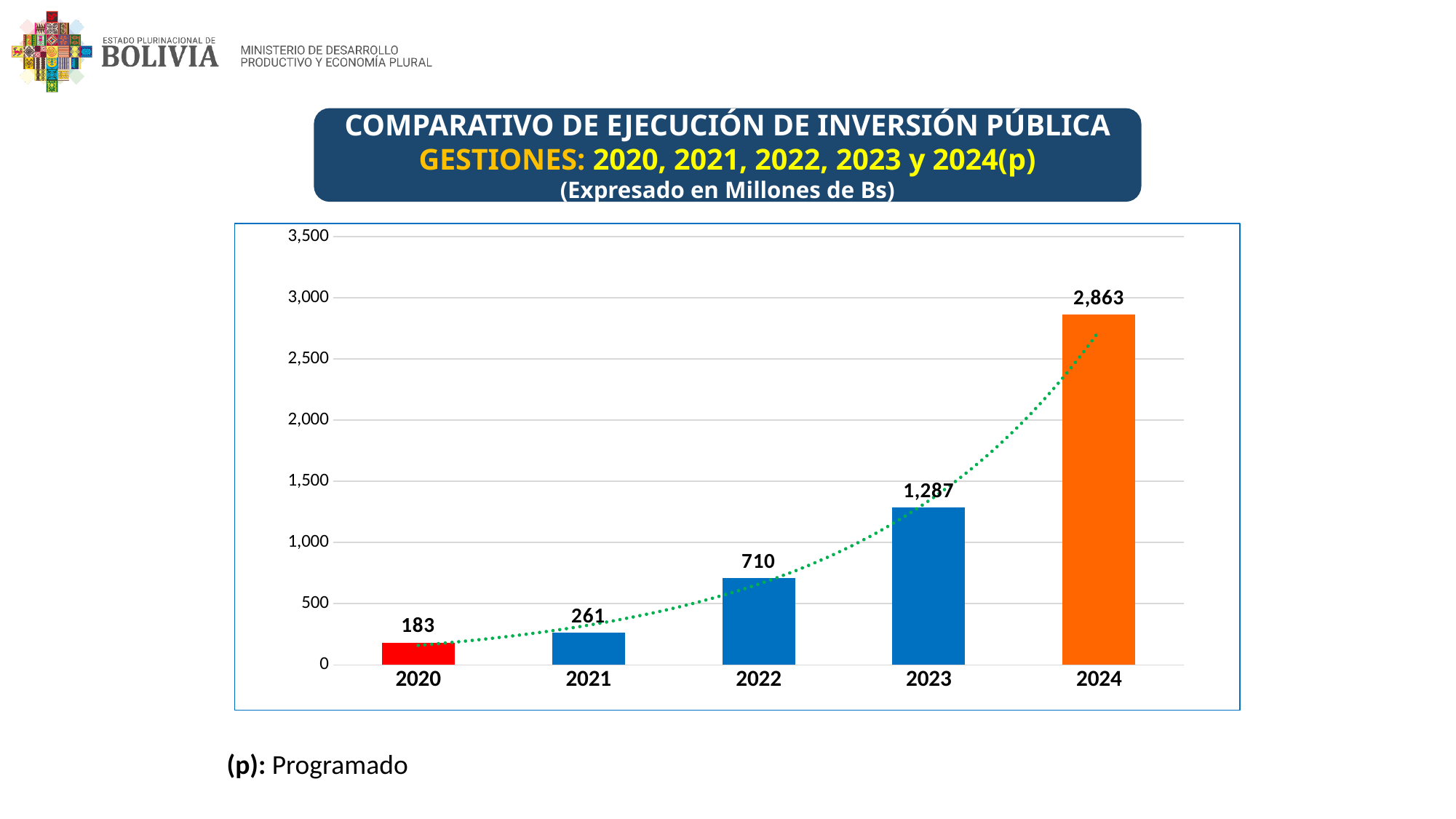
Is the value for 2023 greater or less than 1,000? greater What is the difference between the values for 2024 and 2023? 1,576 What is the value for 2022? 710 What is the value for 2024? 2,863 Do the values rise or fall from 2020 to 2024? rise Which year has the lowest value? 2020 Which year has the highest value? 2024 Which is larger, the value for 2022 or the value for 2023? 2023 What is the difference between the values for 2021 and 2020? 78 What kind of chart is shown? bar chart What is the value for 2020? 183 How many years are shown on the x axis? 5